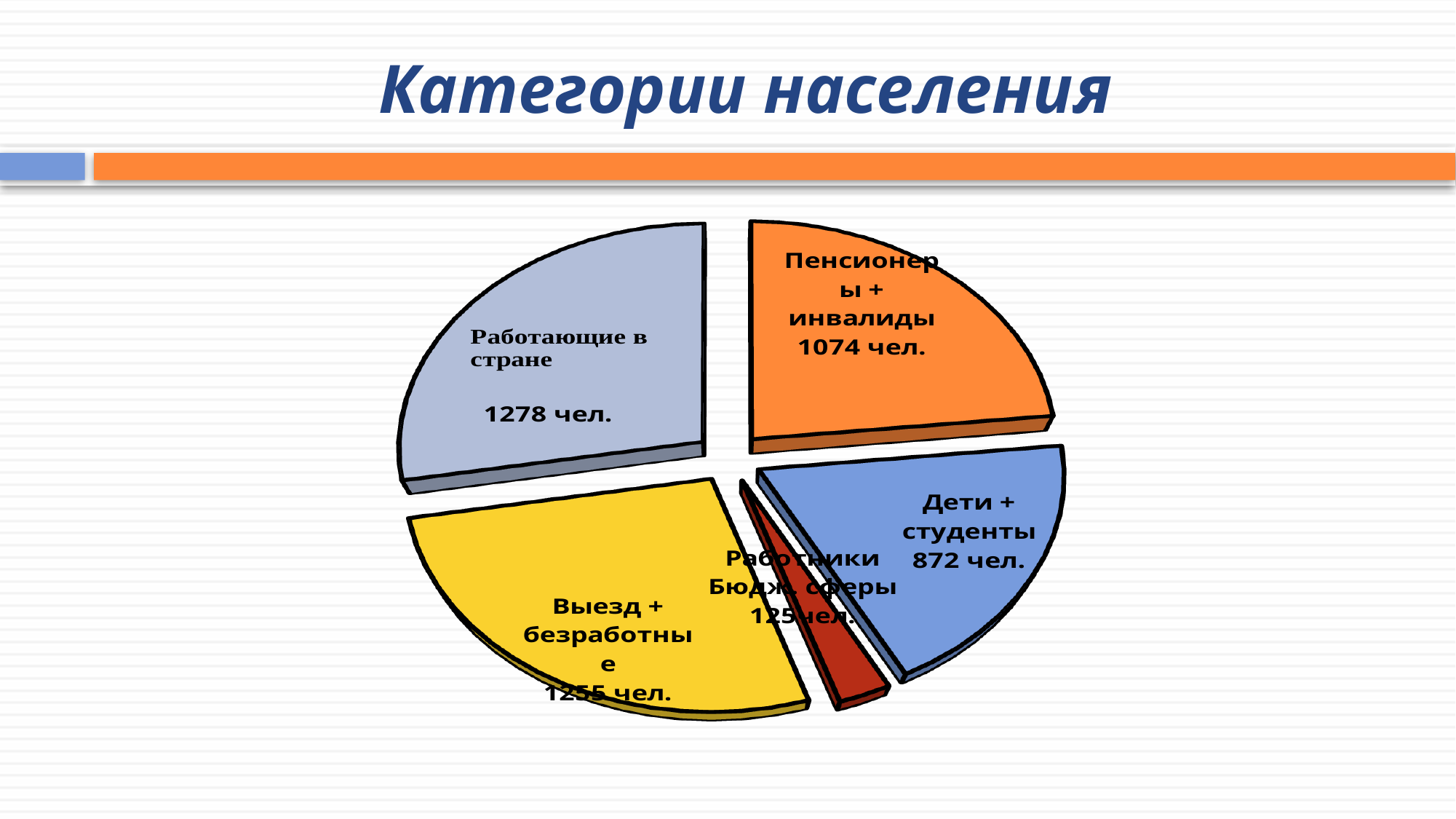
What is the value for Выезд + безработные? 1255 чел. What is the value for Дети + студенты? 872 чел. What is the value for Работники Бюдж. сферы? 125 чел. Which category has the largest value? Работающие в стране How many categories (slices) does the pie chart have? 5 What is the value for Пенсионеры + инвалиды? 1074 чел. Which category has the smallest value? Работники Бюдж. сферы What kind of chart is shown on the slide? Pie chart What is the title of the chart? Категории населения What is the difference between Пенсионеры + инвалиды and Дети + студенты? 202 чел. Which is larger: Работающие в стране or Выезд + безработные? Работающие в стране What is the value for Работающие в стране? 1278 чел.